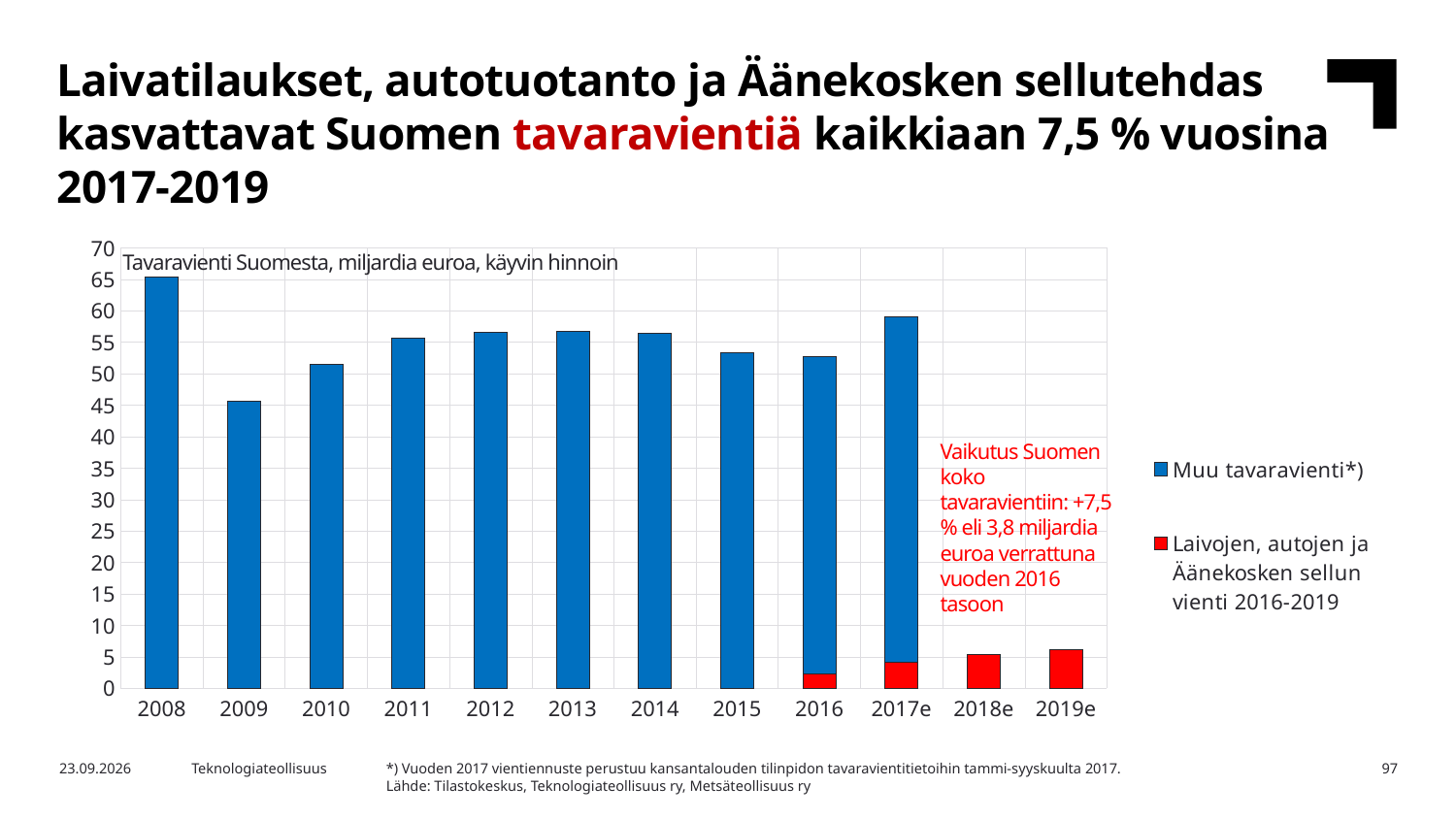
Which year has the highest value for Muu tavaravienti*)? 2008 Which is larger, the total bar for 2016 or for 2017e? 2017e Is the value for 2018e greater or less than 10? less Which year has the lowest value for Muu tavaravienti*)? 2009 Do the values rise or fall from 2009 to 2013? rise What kind of chart is shown on the slide? bar chart How many years are shown on the x axis? 12 Is the total bar for 2017e greater or less than 55? greater How many series does the legend list? 2 Is the value for 2008 greater or less than 60? greater What is the title printed inside the chart area? Tavaravienti Suomesta, miljardia euroa, käyvin hinnoin